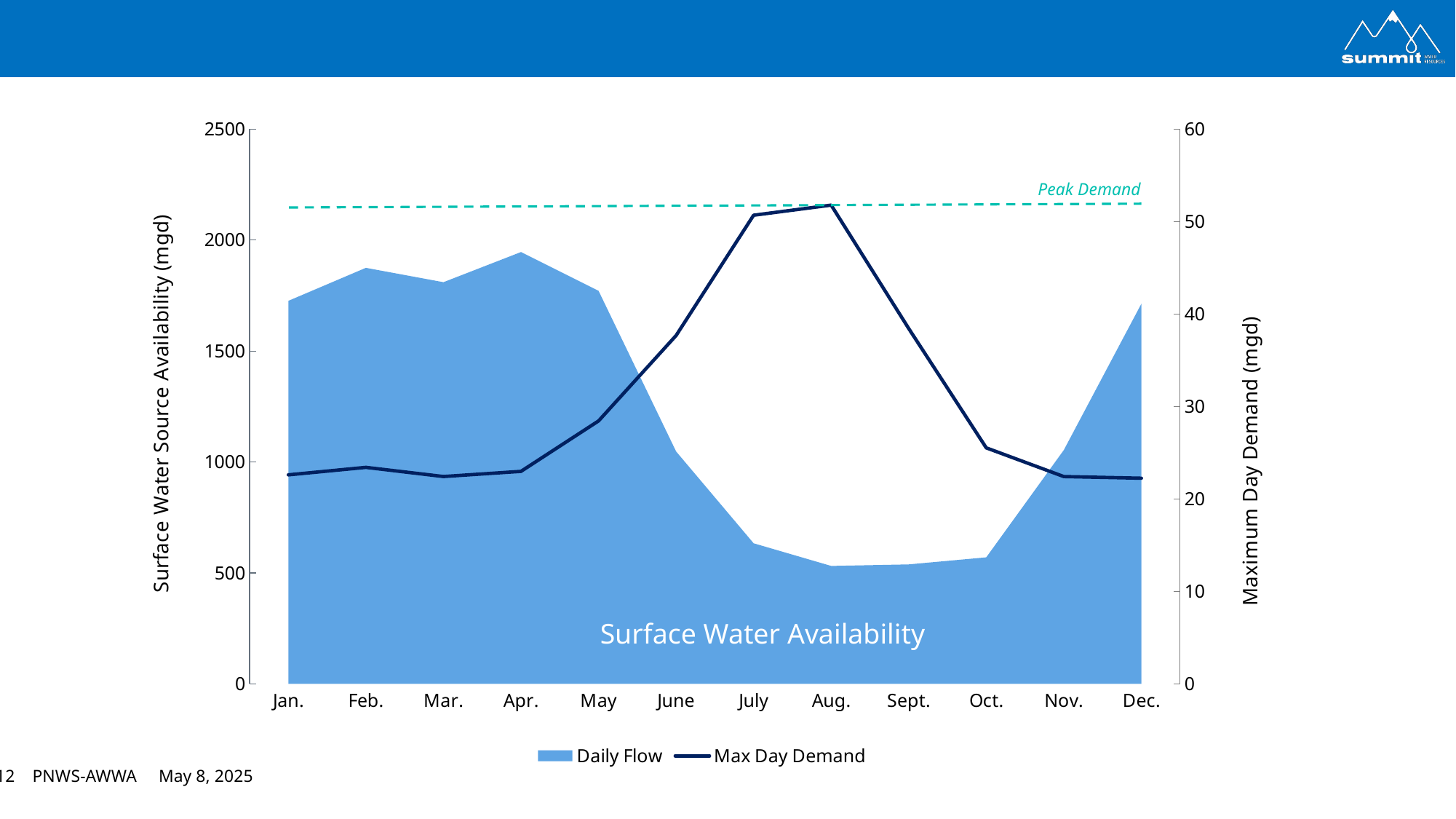
What label is given to the dashed horizontal line near the top of the chart? Peak Demand Does Max Day Demand rise or fall from Jan. to Aug.? rise How many months are plotted along the x axis? 12 Is the Max Day Demand value for Jan. greater or less than 30? less In which month does Max Day Demand reach its highest value? Aug. In which month is Daily Flow highest? Apr. What kind of chart is shown on the slide? A combined area and line chart Is the Daily Flow value for Jan. greater or less than 1500? greater How many series does the legend list? 2 Which month has the larger Daily Flow, June or Dec.? Dec. Is the Max Day Demand value for Aug. greater or less than 50? greater